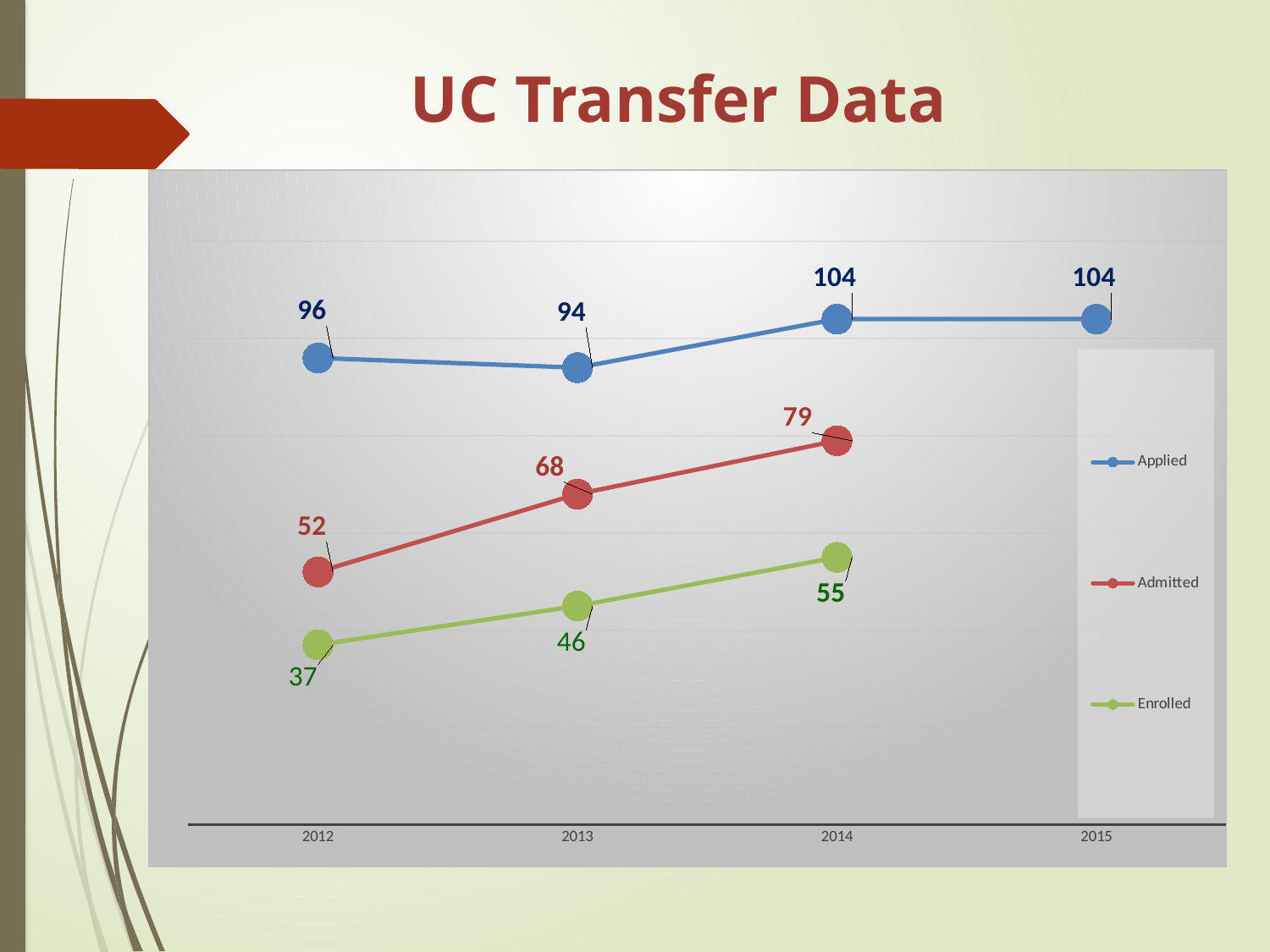
What is the Applied value for 2012? 96 What kind of chart is shown on the slide? Line chart How many series does the legend list? 3 How many years are shown on the x axis? 4 What is the Admitted value for 2013? 68 What is the difference between the Applied and Admitted values in 2014? 25 What is the Enrolled value for 2014? 55 In which year is the Enrolled value lowest? 2012 In which year is the Admitted value highest? 2014 What is the Applied value for 2015? 104 Does the Enrolled series rise or fall from 2012 to 2014? Rise Which is larger in 2013: the Admitted value or the Enrolled value? Admitted